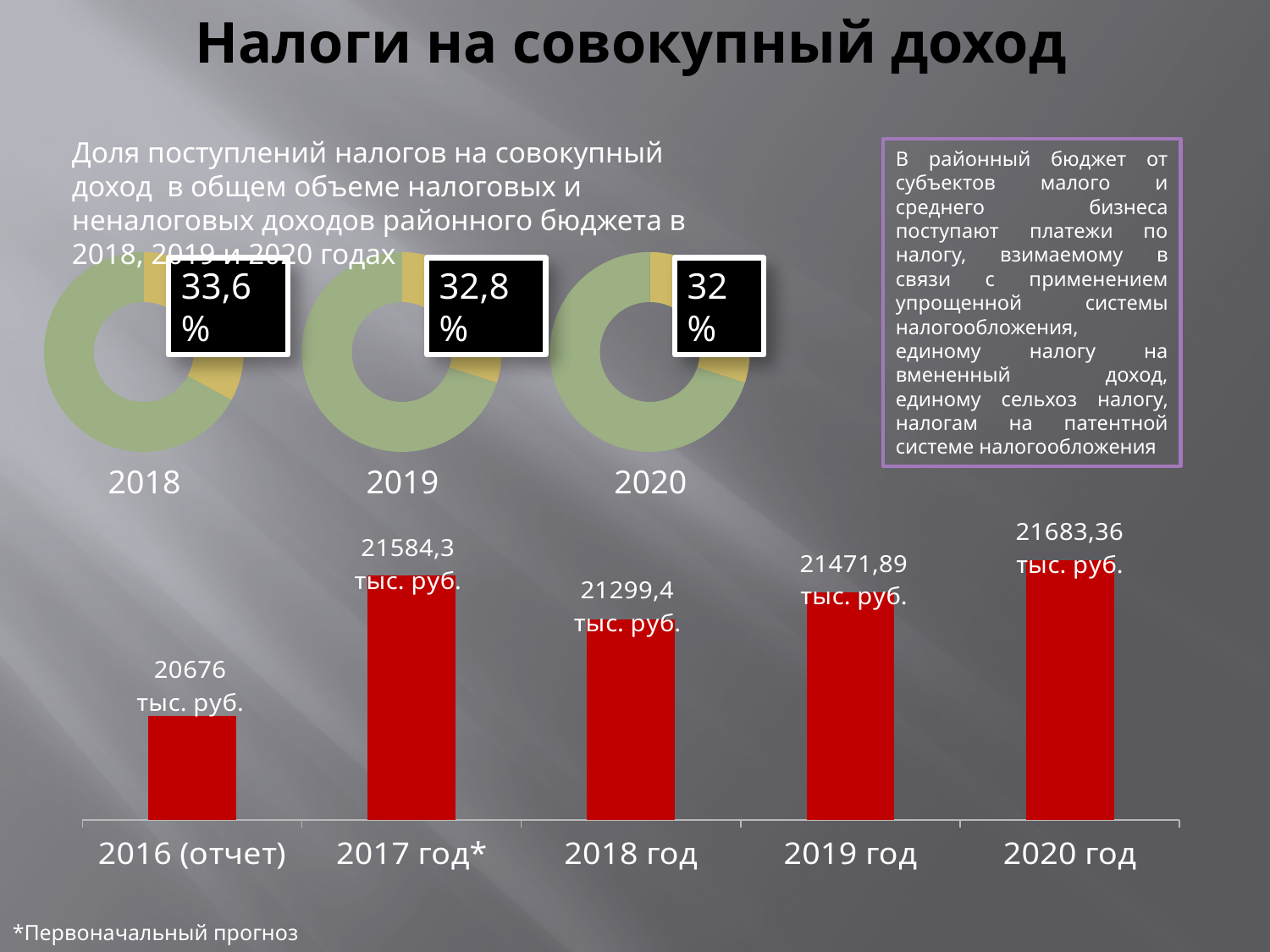
In the bar chart at the bottom of the slide, which category has the highest value? 2020 год In the bar chart at the bottom of the slide, does the value rise or fall from 2018 год to 2020 год? rise In the bar chart at the bottom of the slide, which category has the lowest value? 2016 (отчет) How many donut charts are shown on the slide? 3 In the bar chart at the bottom of the slide, what is the difference between the values for 2020 год and 2016 (отчет)? 1007,36 тыс. руб. How many bars are in the bar chart at the bottom of the slide? 5 Which of the three donut charts (2018, 2019, 2020) shows the highest percentage? 2018 In the donut chart labelled 2019, what share is shown in the label? 32,8% In the bar chart at the bottom of the slide, which is larger: the value for 2017 год* or the value for 2018 год? 2017 год* In the bar chart at the bottom of the slide, what is the value for 2019 год? 21471,89 тыс. руб. What kind of chart is shown at the bottom of the slide? bar chart In the bar chart at the bottom of the slide, what is the value for 2016 (отчет)? 20676 тыс. руб.